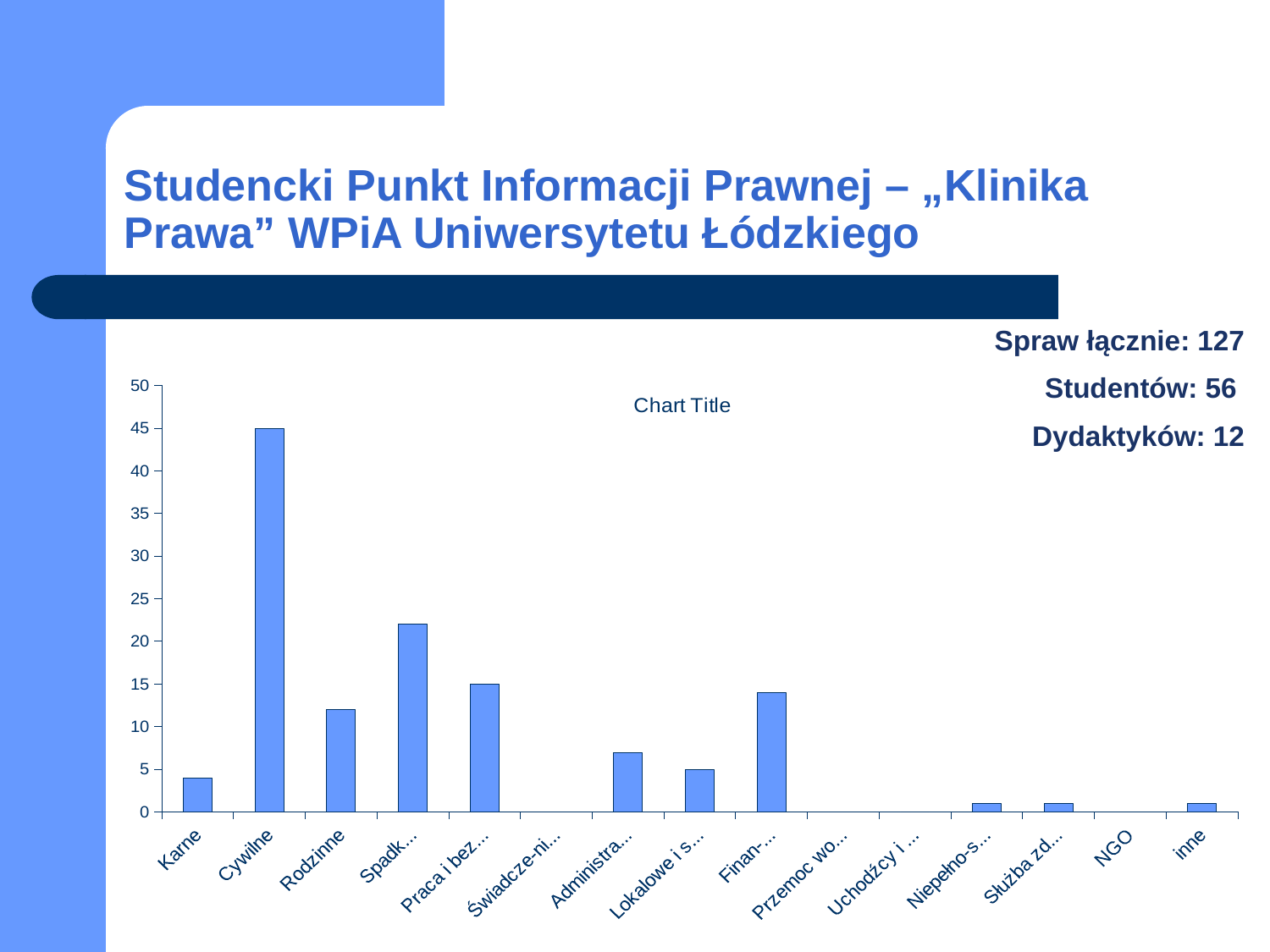
Is the value for Rodzinne greater or less than 10? greater Which is larger, the value for Spadk... or the value for Praca i bez...? Spadk... What is the difference between the values for Cywilne and Praca i bez...? 30 What is the value for Lokalowe i s...? 5 Is the value for Spadk... greater or less than 20? greater What is the value for Praca i bez...? 15 What is the value for Cywilne? 45 Is the value for Karne greater or less than 5? less Which category has the highest value in the chart? Cywilne What kind of chart is shown on the slide? bar chart How many categories are shown on the x axis of the chart? 15 What is the title shown on the chart? Chart Title